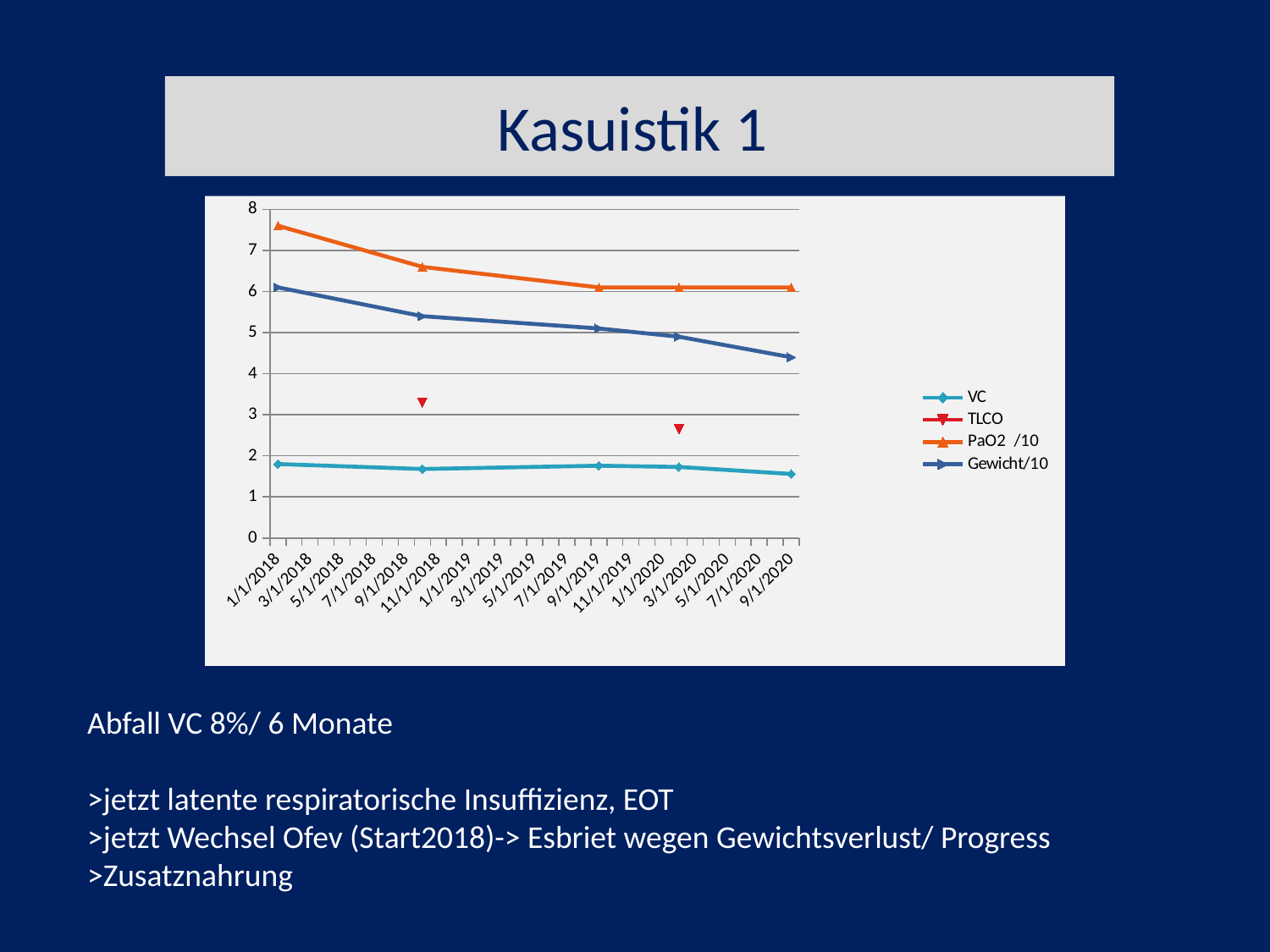
Does the PaO2 /10 series rise or fall over the period shown? fall Which series are listed in the legend? VC, TLCO, PaO2 /10, Gewicht/10 Is the value for PaO2 /10 at 1/1/2018 greater or less than 7? greater At 1/1/2018, which is larger: PaO2 /10 or Gewicht/10? PaO2 /10 Is the value for TLCO at 3/1/2020 greater or less than 3? less How many data points are plotted for the TLCO series? 2 Does the Gewicht/10 series rise or fall from 1/1/2018 to 9/1/2020? fall What kind of chart is shown on the slide? line chart How many series does the legend list? 4 Is the value for Gewicht/10 at 9/1/2020 greater or less than 5? less Which series has the lowest values throughout the chart? VC